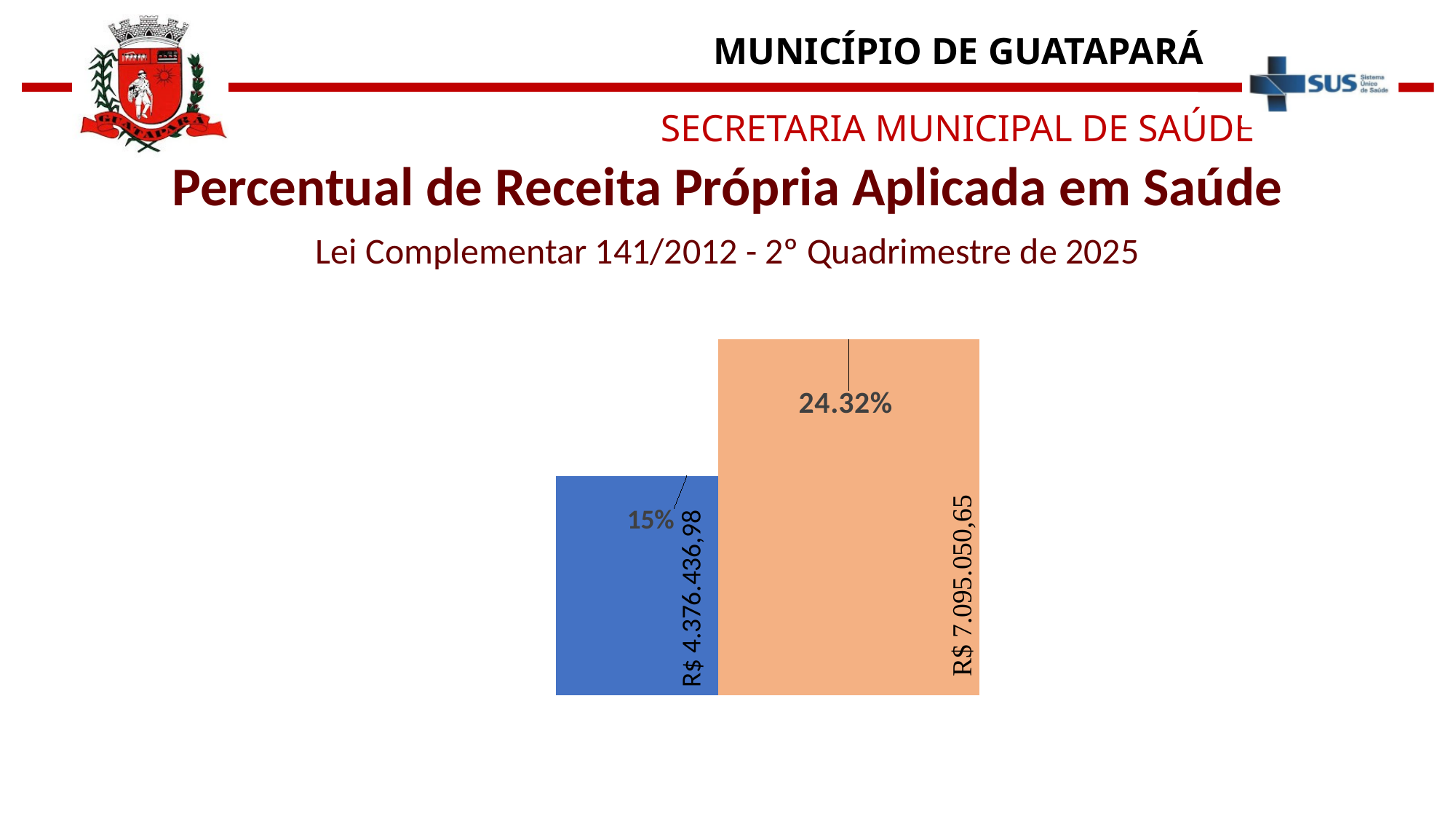
What percentage is labelled on the blue bar? 15% What kind of chart is shown on the slide? bar chart What is the title of the chart on the slide? Percentual de Receita Própria Aplicada em Saúde What monetary value is printed on the blue (left) bar? R$ 4.376.436,98 Is the value on the blue bar larger or smaller than the value on the orange bar? smaller Which bar is taller, the blue one or the orange one? the orange one How many bars are plotted in the chart? 2 What is the difference between the monetary values on the orange bar and the blue bar? R$ 2.718.613,67 What is the difference in percentage points between the orange bar (24.32%) and the blue bar (15%)? 9.32 What monetary value is printed on the orange (right) bar? R$ 7.095.050,65 Which bar shows the lowest percentage? the blue bar (15%) What percentage is labelled on the orange bar? 24.32%